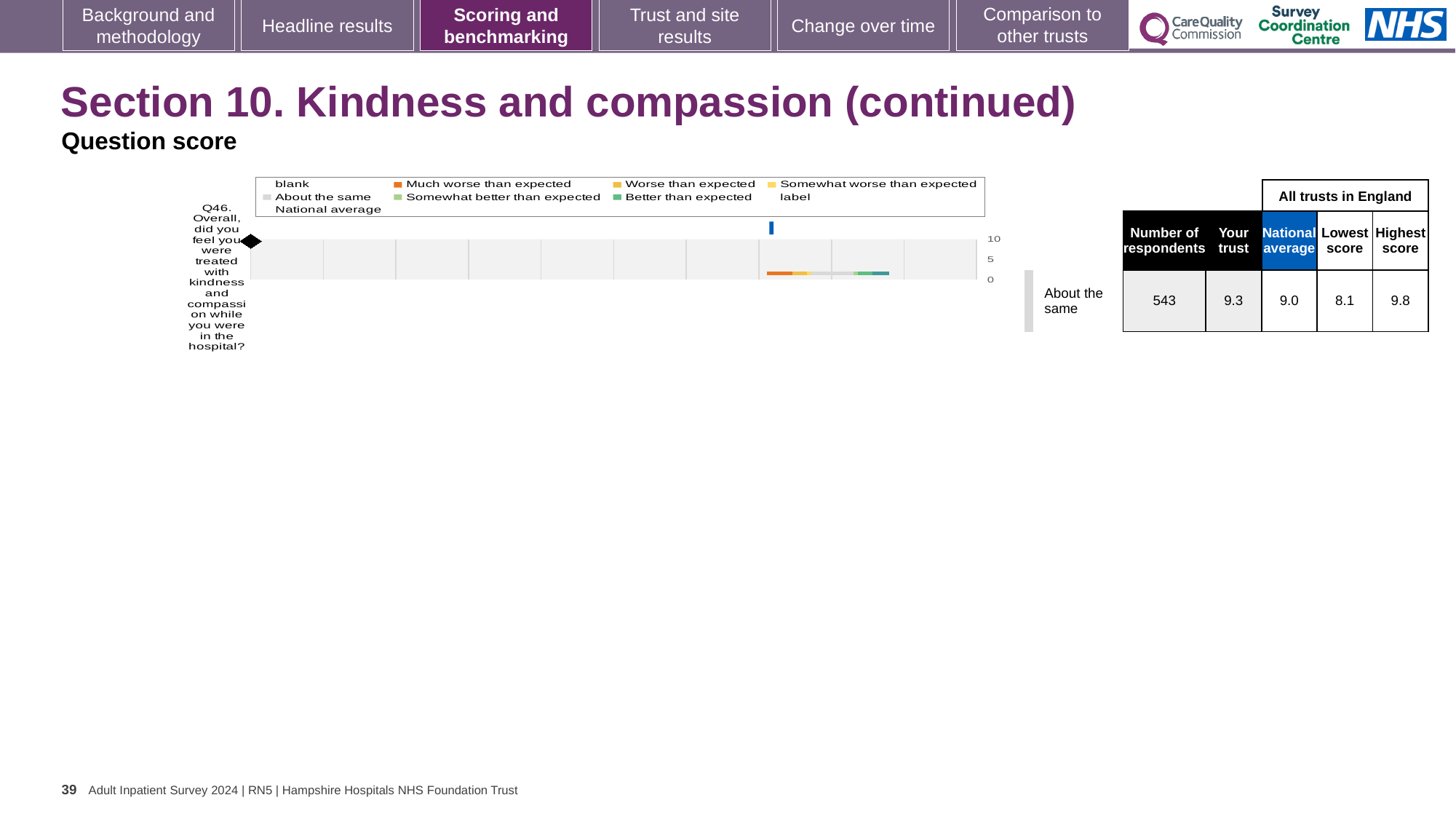
What is the lowest score among all trusts in England for Q46? 8.1 Is the national average marker for Q46 greater or less than 5 on the chart's axis? greater How many questions (categories) are plotted on the chart? 1 What kind of chart is shown on the slide? bar chart What is the 'Your trust' score for Q46? 9.3 What is the highest score among all trusts in England for Q46? 9.8 What is the national average score for Q46? 9.0 What is the highest value shown on the chart's horizontal axis? 10 What is the number of respondents for Q46 shown in the table? 543 Which question is plotted on the chart? Q46. Overall, did you feel you were treated with kindness and compassion while you were in the hospital? What is the difference between the highest score and the lowest score for Q46? 1.7 Which is larger for Q46, the 'Your trust' score or the national average? Your trust